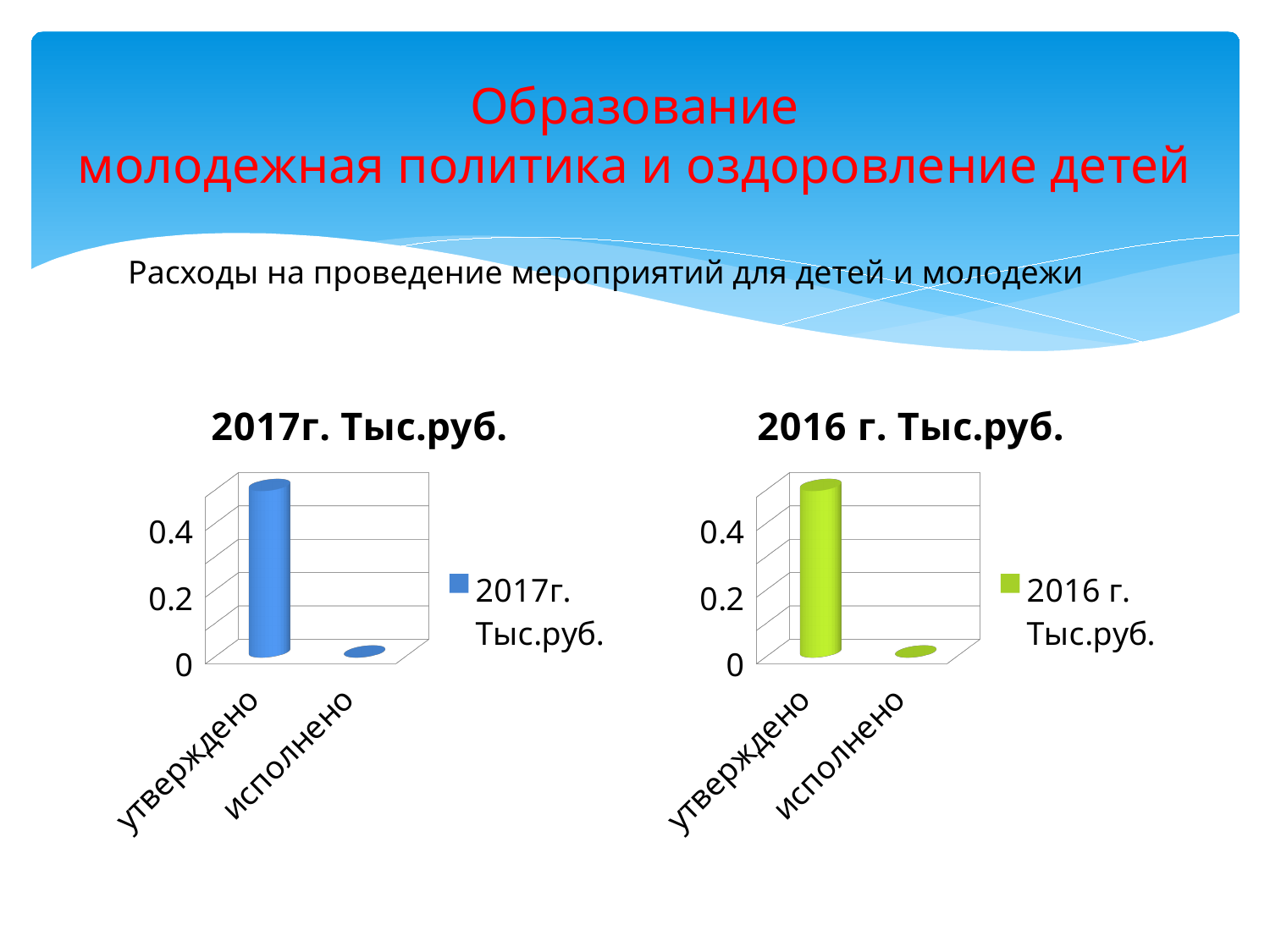
In the "2016 г. Тыс.руб." chart, is the value for исполнено greater or less than 0.2? less What is the legend entry of the chart on the left? 2017г. Тыс.руб. What colour are the bars in the "2016 г. Тыс.руб." chart? green How many series does the legend of the "2016 г. Тыс.руб." chart list? 1 In the "2016 г. Тыс.руб." chart, which is larger: утверждено or исполнено? утверждено In the "2016 г. Тыс.руб." chart, which category has the lowest value? исполнено In the "2017г. Тыс.руб." chart, is the value for утверждено greater or less than 0.4? greater What kind of chart is the "2017г. Тыс.руб." chart? bar chart What kind of chart is the "2016 г. Тыс.руб." chart? bar chart In the "2017г. Тыс.руб." chart, is the value for исполнено greater or less than 0.2? less How many categories are shown on the x axis of the "2017г. Тыс.руб." chart? 2 In the "2017г. Тыс.руб." chart, which category has the highest value? утверждено